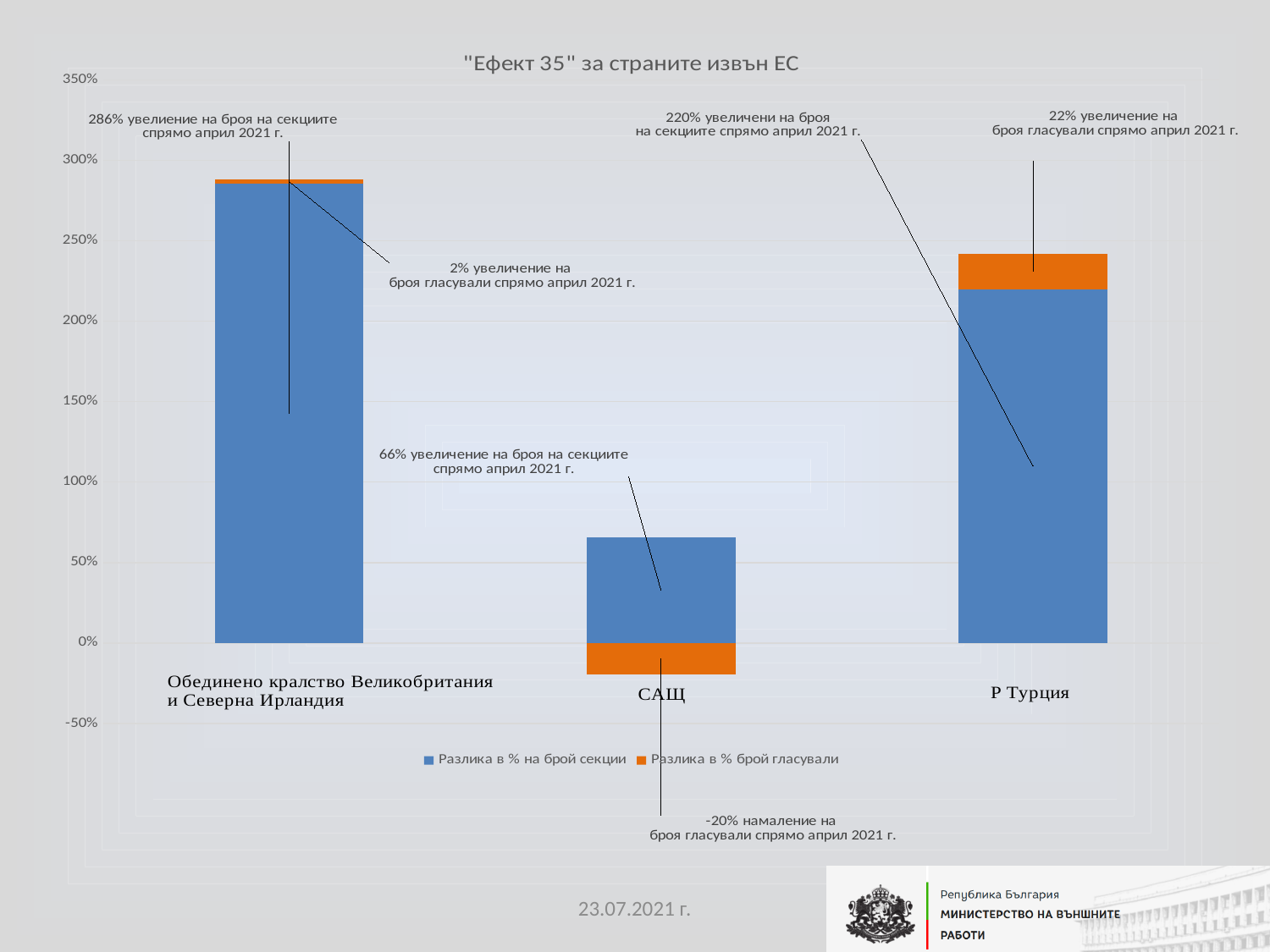
Which country has the highest increase in the number of polling sections? Обединено кралство Великобритания и Северна Ирландия Is the polling-section increase for САЩ greater or less than 100%? less How many series does the legend list? 2 How many countries (categories) are shown on the x axis? 3 What is the title of the chart? "Ефект 35" за страните извън ЕС What kind of chart is shown on the slide? stacked bar chart What is the percentage increase in the number of polling sections for Р Турция? 220% What is the difference between the polling-section increase for Р Турция and for САЩ? 154% Which country has the lowest value for the change in the number of voters? САЩ What is the percentage increase in the number of polling sections (Разлика в % на брой секции) for Обединено кралство Великобритания и Северна Ирландия? 286% What is the percentage increase in the number of voters for Р Турция? 22% What is the percentage change in the number of voters (Разлика в % брой гласували) for САЩ? -20%